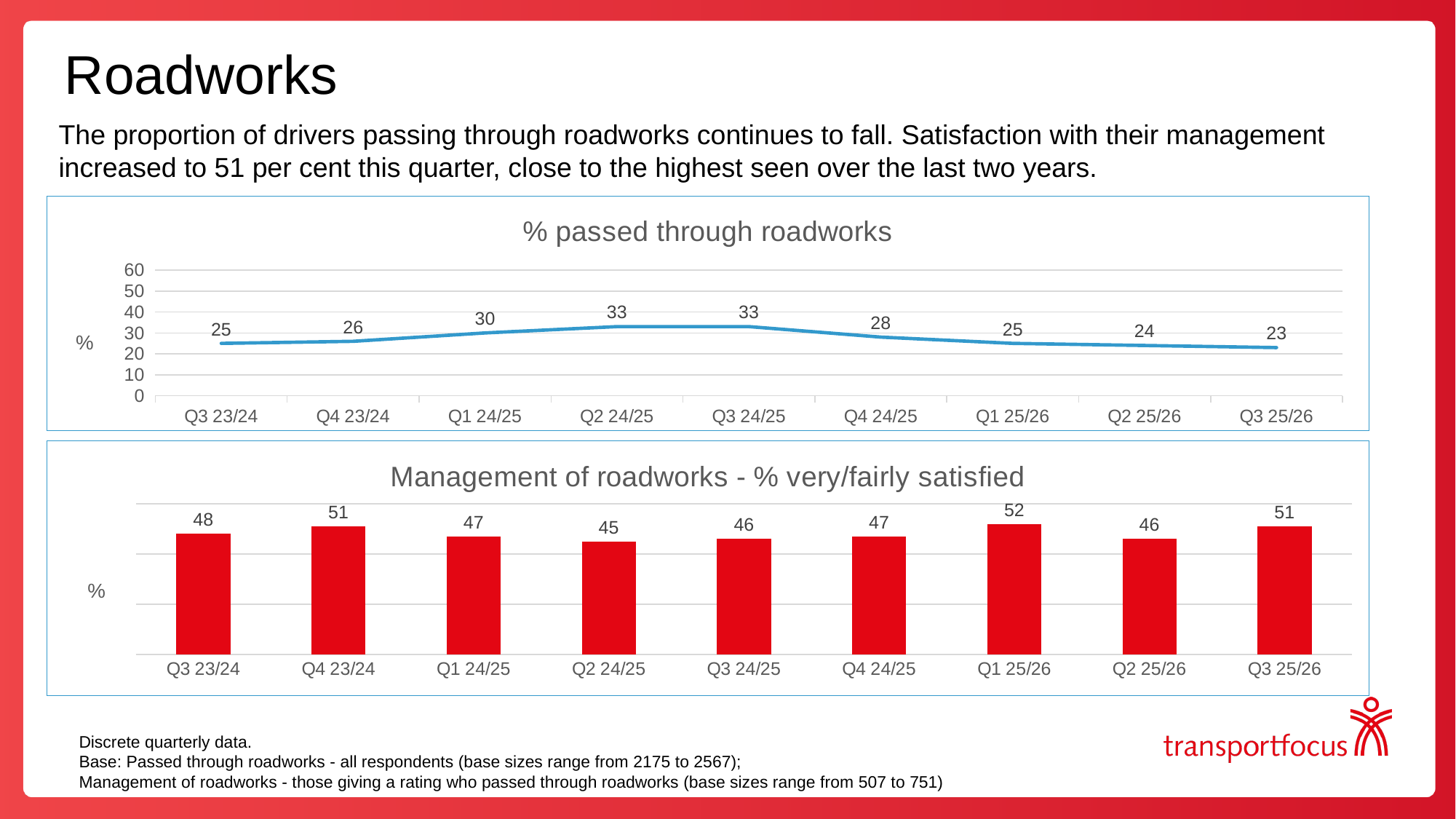
In the '% passed through roadworks' chart, which quarter has the lowest value? Q3 25/26 In the 'Management of roadworks - % very/fairly satisfied' chart, which quarter has the lowest value? Q2 24/25 In the '% passed through roadworks' chart, how many quarters are plotted? 9 In the '% passed through roadworks' chart, what is the difference between the Q3 24/25 value and the Q3 25/26 value? 10 In the 'Management of roadworks - % very/fairly satisfied' chart, what is the value for Q1 25/26? 52 In the 'Management of roadworks - % very/fairly satisfied' chart, what is the difference between the Q3 25/26 value and the Q2 25/26 value? 5 In the '% passed through roadworks' chart, what is the value for Q2 24/25? 33 In the '% passed through roadworks' chart, do the values rise or fall from Q3 24/25 to Q3 25/26? Fall What kind of chart is the 'Management of roadworks - % very/fairly satisfied' chart? Bar chart In the '% passed through roadworks' chart, what is the value for Q3 25/26? 23 What kind of chart is the '% passed through roadworks' chart? Line chart In the 'Management of roadworks - % very/fairly satisfied' chart, which quarter has the highest value? Q1 25/26